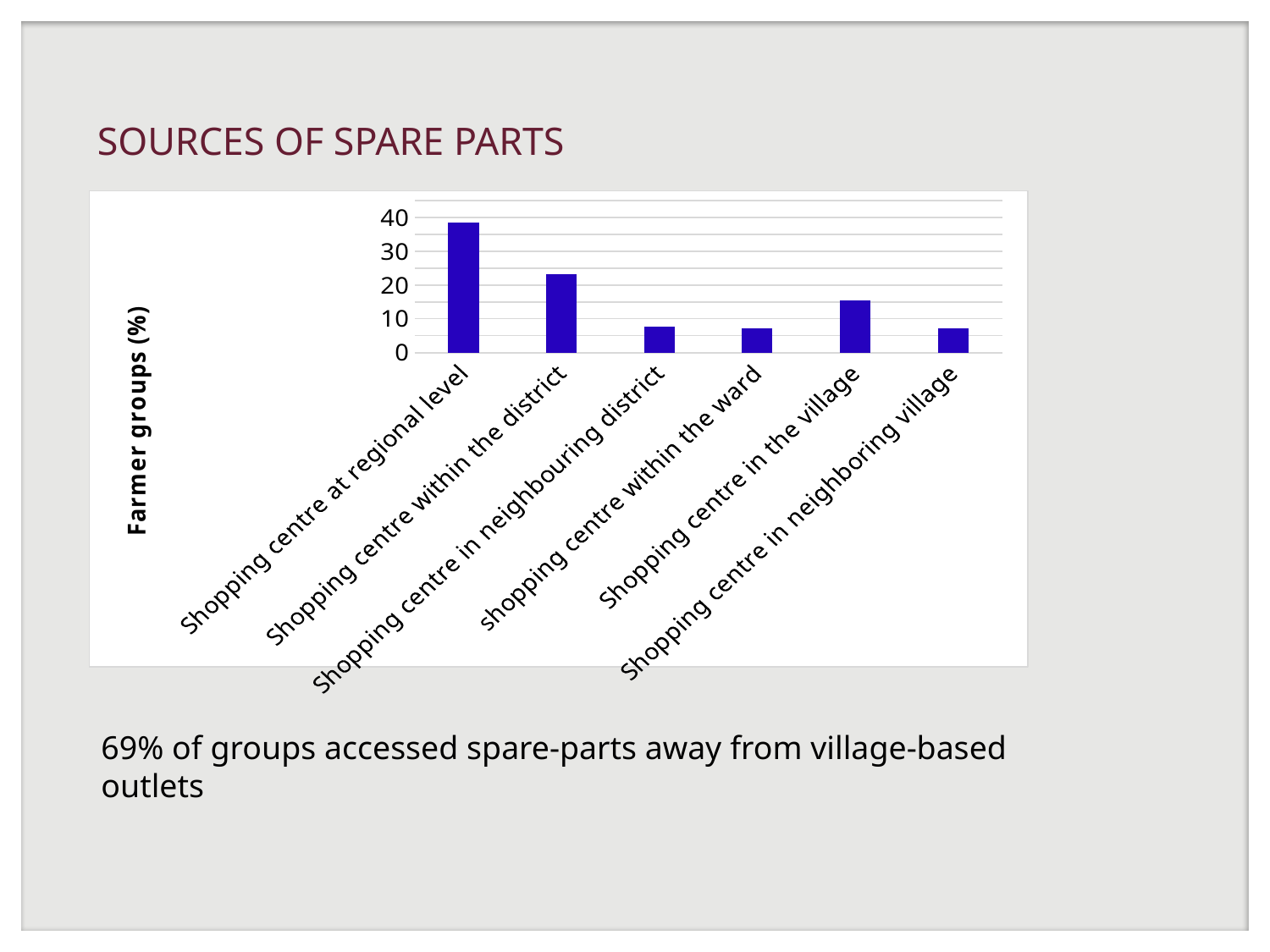
What kind of chart is shown on the slide? bar chart Which is larger: the value for Shopping centre at regional level or Shopping centre within the district? Shopping centre at regional level What is the title of the slide containing the chart? SOURCES OF SPARE PARTS How many categories (bars) does the chart show? 6 What is the label on the vertical axis of the chart? Farmer groups (%) Which is larger: the value for Shopping centre in the village or shopping centre within the ward? Shopping centre in the village Which category has the highest value? Shopping centre at regional level Is the value for Shopping centre in neighbouring district greater or less than 10? less Is the value for Shopping centre within the district greater or less than 30? less Is the value for Shopping centre in the village greater or less than 10? greater